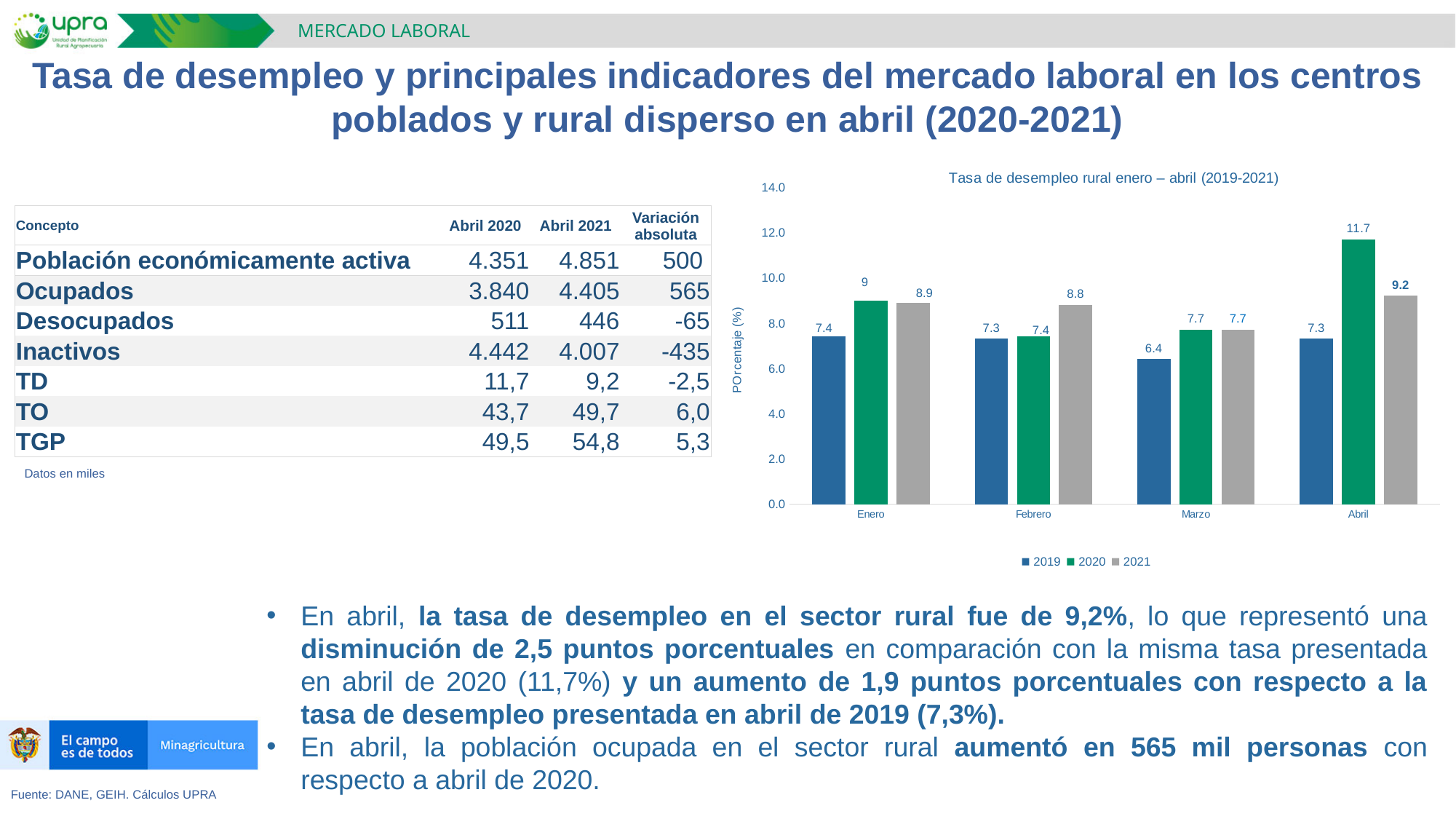
What is the difference between the 2020 and 2021 unemployment rates in Abril? 2.5 In which month is the 2020 unemployment rate highest? Abril Is the 2020 unemployment rate in Abril greater or less than 10.0? greater How many series does the chart legend list? 3 What is the unemployment rate for 2020 in Abril? 11.7 Which is larger in Enero: the 2020 rate or the 2021 rate? 2020 What is the unemployment rate for 2021 in Febrero? 8.8 What is the title of the chart? Tasa de desempleo rural enero – abril (2019-2021) What kind of chart is shown on the slide? bar chart What is the unemployment rate for 2019 in Marzo? 6.4 In which month is the 2019 unemployment rate lowest? Marzo How many months are shown on the x axis of the chart? 4